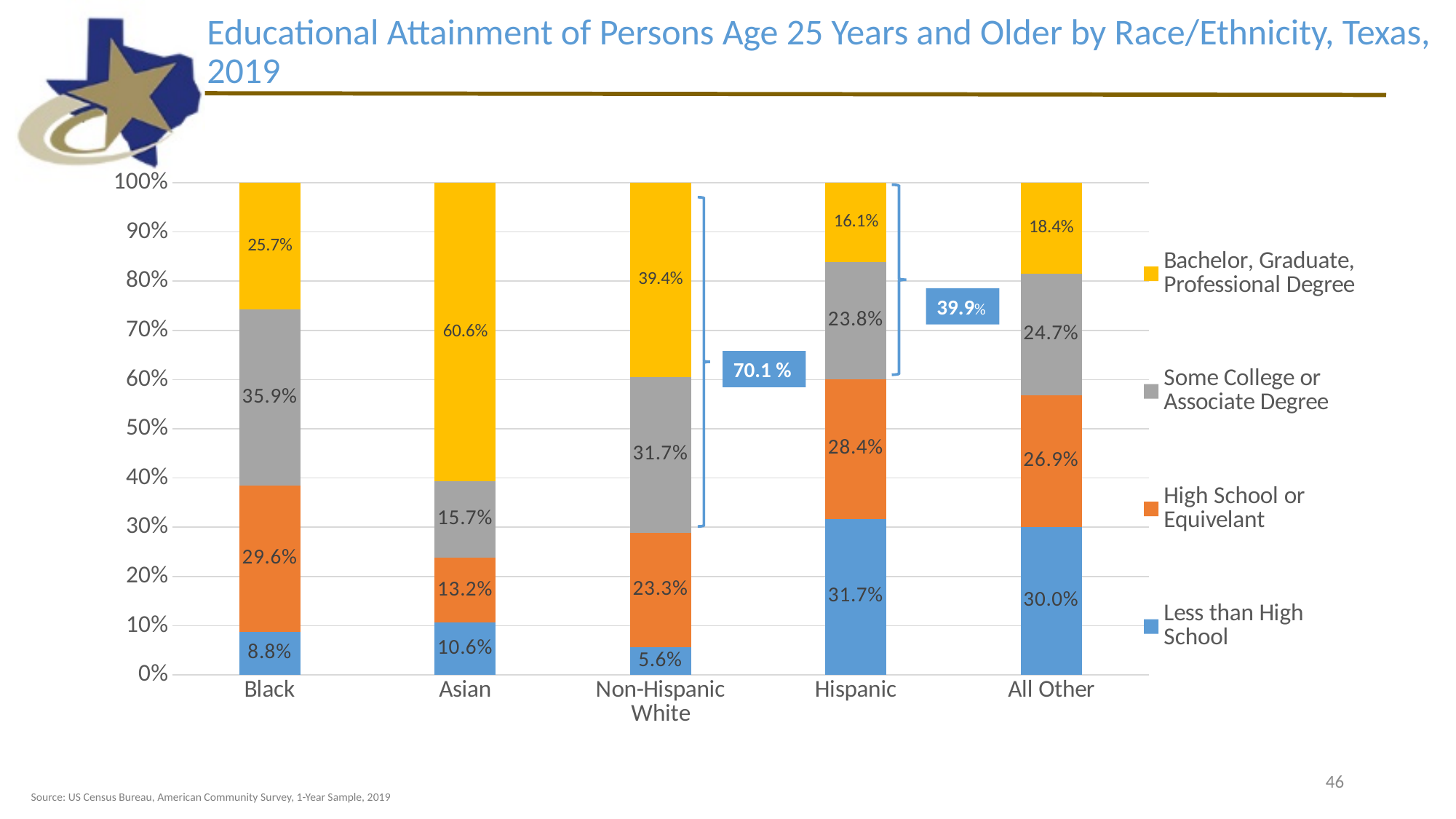
Which race/ethnicity group has the highest share with a Bachelor, Graduate, or Professional Degree? Asian How many series does the legend list? 4 Which is larger: the High School or Equivalent share for Black persons or for Asian persons? Black What is the total of the four segments in the Black bar? 100.0% What kind of chart is shown on the slide? Stacked bar chart What is the Less than High School share for Hispanic persons? 31.7% Which legend entry is shown in yellow? Bachelor, Graduate, Professional Degree Which group has the lowest Less than High School share? Non-Hispanic White What is the Some College or Associate Degree value for the All Other group? 24.7% What percentage of Black persons age 25 and older have a Bachelor, Graduate, or Professional Degree? 25.7% What is the difference between the Bachelor, Graduate, Professional Degree shares for Asian and Hispanic persons? 44.5% How many race/ethnicity categories are shown on the x axis? 5